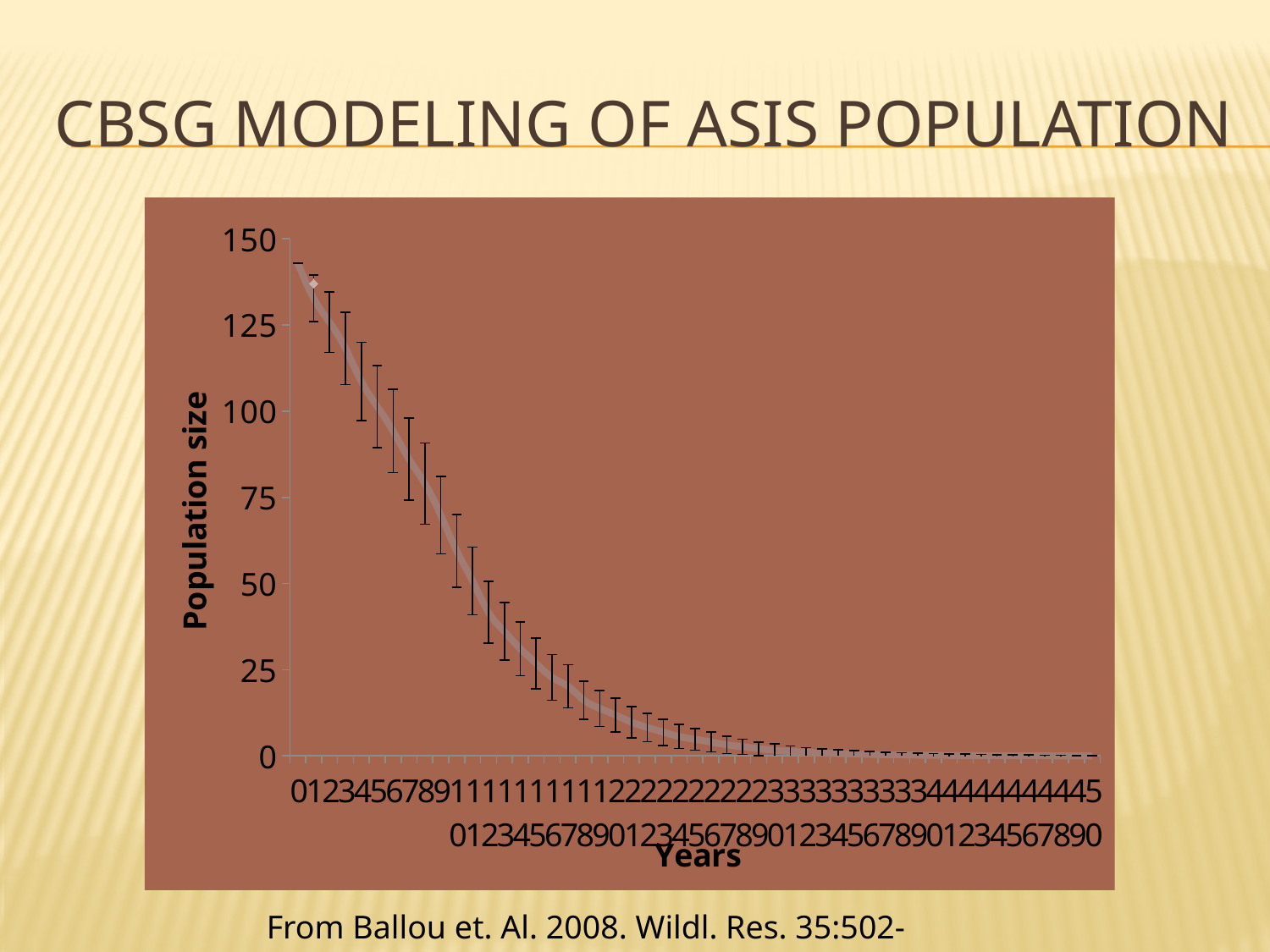
Does the population size rise or fall as the years increase along the x axis? fall Is the population size at year 30 greater or less than 25? less At which year is the population size highest? 0 What is the label of the vertical axis? Population size What is the highest value shown on the vertical axis? 150 What is the title of the chart on the slide? CBSG MODELING OF ASIS POPULATION What kind of chart is shown on the slide? line chart Is the population size at year 20 greater or less than 50? less What is the last year shown on the horizontal axis? 50 Is the population size at year 0 greater or less than 125? greater Which is larger, the population size at year 10 or at year 40? year 10